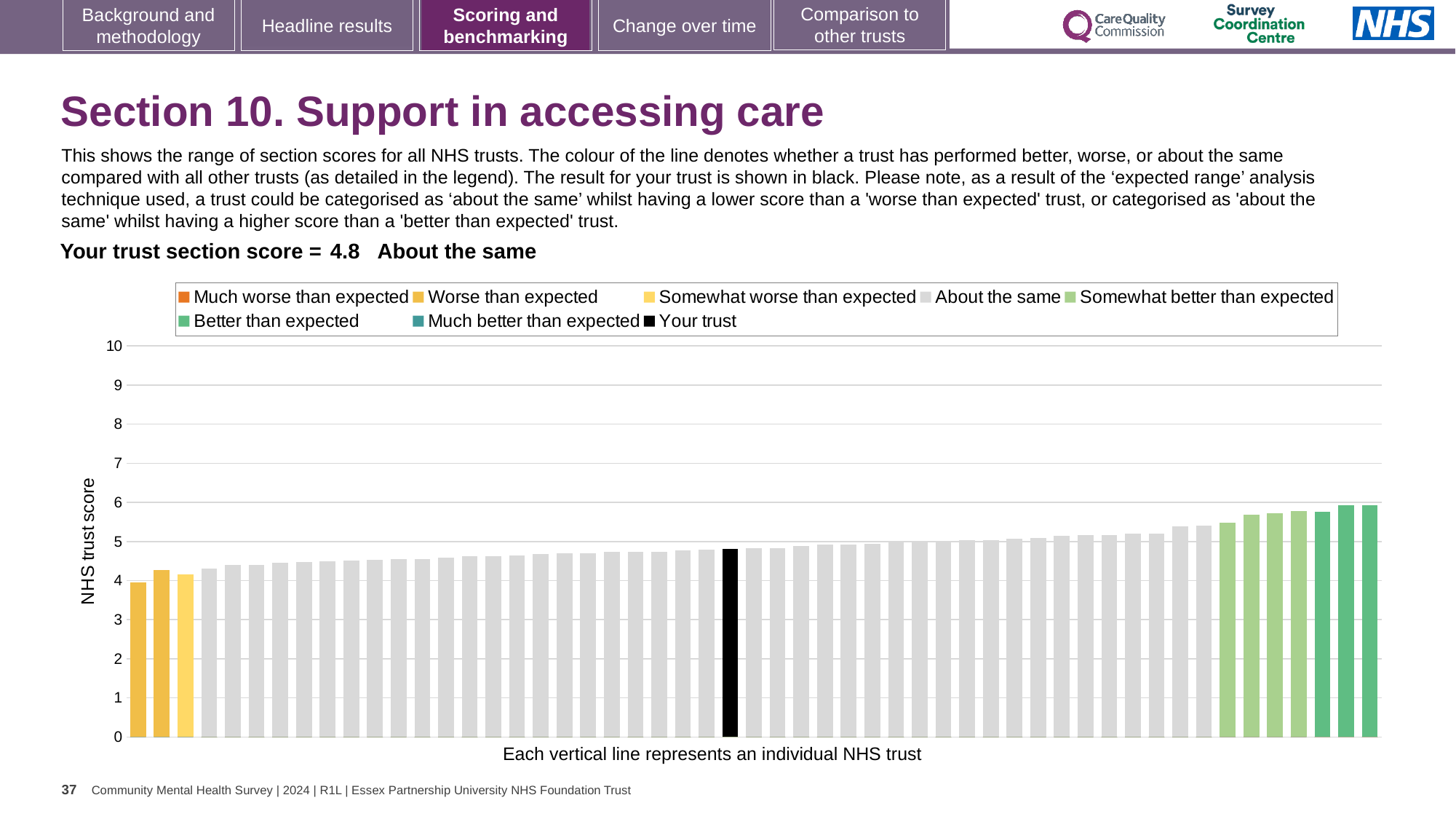
What kind of chart is shown on the slide? bar chart What is the label on the vertical axis of the chart? NHS trust score Is the value of the leftmost bar greater or less than 5? less Which is larger, the leftmost bar or the rightmost bar? the rightmost bar Do the bar values rise or fall from left to right across the chart? rise How many entries does the chart legend list? 8 How many bars are coloured as 'Worse than expected' (yellow)? 2 What category is the trust's section score placed in, according to the text above the chart? About the same What is the trust section score shown on the slide? 4.8 Is the value of the black 'Your trust' bar greater or less than 5? less How many bars are coloured as 'Much better than expected'? 0 Is the value of the tallest bar greater or less than 5? greater